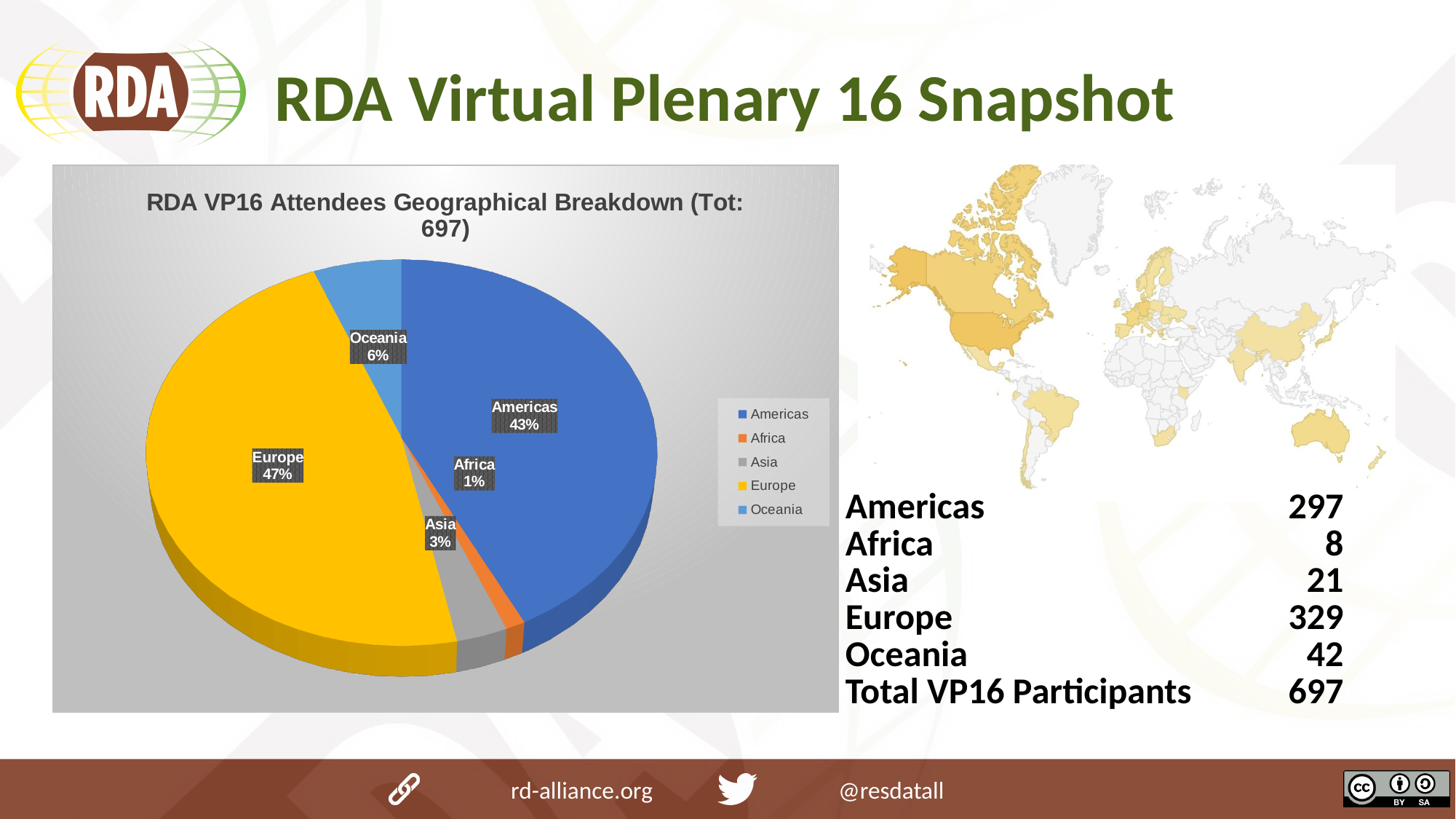
What share of the pie does Americas represent? 43% What percentage is shown for Asia? 3% Which region has the largest slice of the pie? Europe How many entries does the legend list? 5 What is the title of the chart? RDA VP16 Attendees Geographical Breakdown (Tot: 697) What type of chart is shown on the slide? Pie chart What is the difference in percentage points between Europe and Americas? 4 Which slice is larger, Oceania or Asia? Oceania Which region has the smallest slice of the pie? Africa What percentage is shown for Oceania? 6% What share of the pie does Europe represent? 47% How many regions are shown in the pie chart? 5